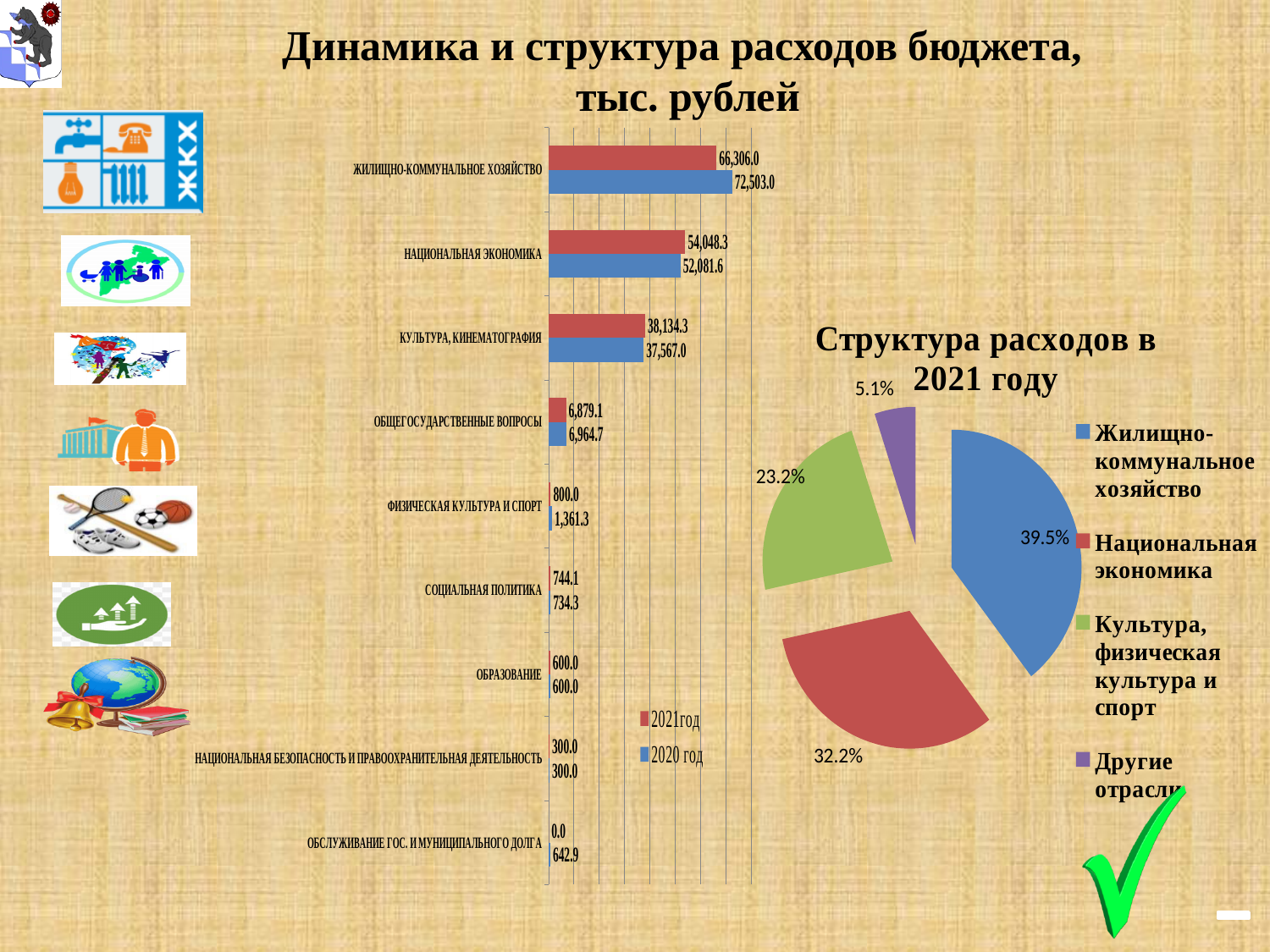
In the bar chart on the left, which category has the lowest 2021 год value? Обслуживание гос. и муниципального долга In the bar chart on the left, what is the 2020 год value for Национальная экономика? 52,081.6 In the pie chart 'Структура расходов в 2021 году', what share does Национальная экономика have? 32.2% In the pie chart 'Структура расходов в 2021 году', which category has the smallest slice? Другие отрасли How many series does the legend of the bar chart on the left list? 2 In the pie chart 'Структура расходов в 2021 году', what is the difference between the shares of Жилищно-коммунальное хозяйство and Культура, физическая культура и спорт? 16.3% In the bar chart on the left, what is the 2021 год value for Жилищно-коммунальное хозяйство? 66,306.0 How many categories does the bar chart on the left show? 9 In the bar chart on the left, what is the difference between the 2020 год and 2021 год values for Жилищно-коммунальное хозяйство? 6,197.0 In the bar chart on the left, which category has the highest 2020 год value? Жилищно-коммунальное хозяйство What kind of chart is the chart on the left of the slide? Bar chart In the bar chart on the left, which is larger for Физическая культура и спорт: the 2021 год value or the 2020 год value? 2020 год